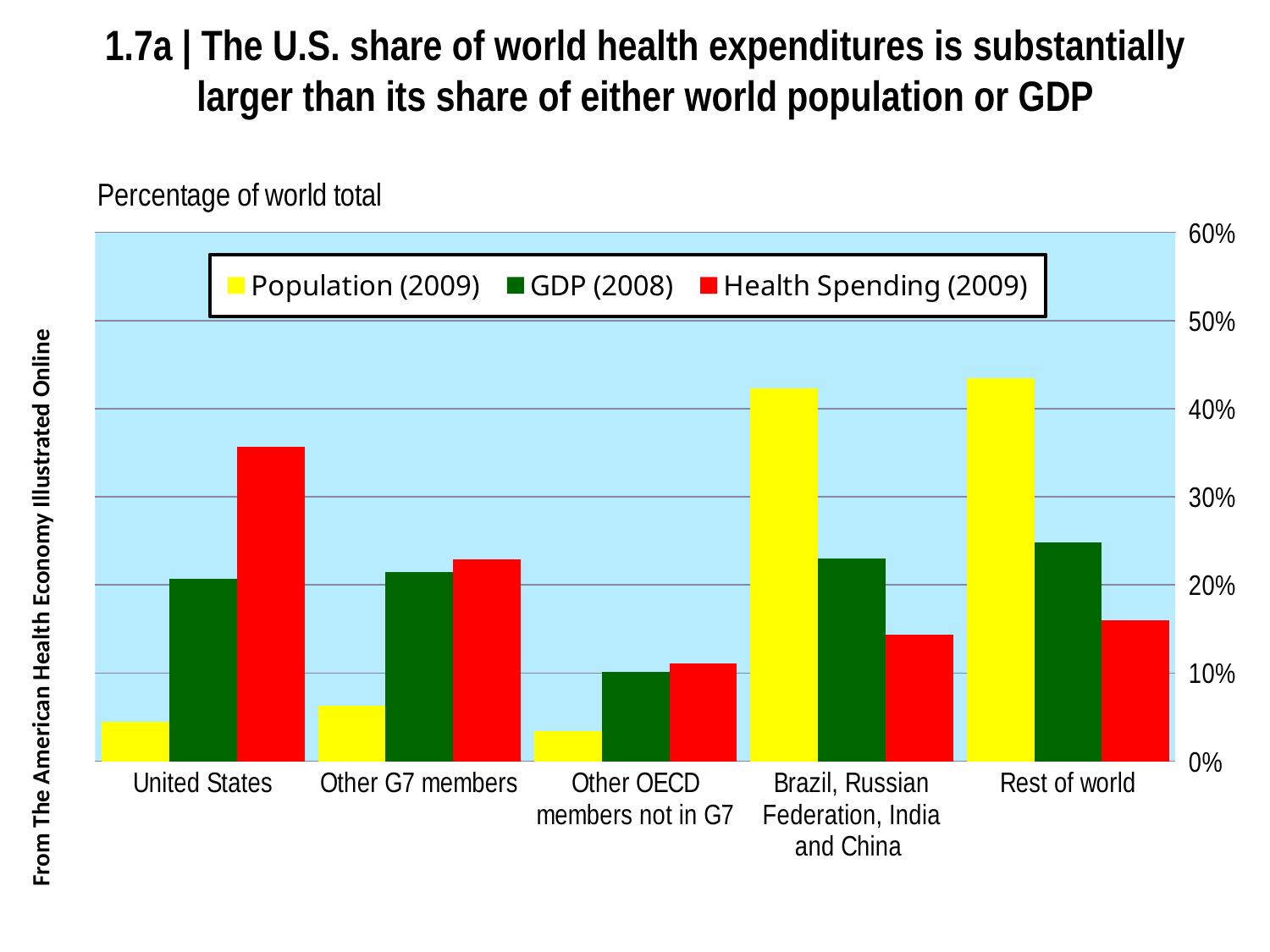
Is the Population (2009) value for Brazil, Russian Federation, India and China greater or less than 40%? greater What does the label above the chart say the values are measured as? Percentage of world total How many categories are shown on the x axis? 5 For Brazil, Russian Federation, India and China, which is larger: Population (2009) or Health Spending (2009)? Population (2009) What kind of chart is shown on the slide? bar chart Is the GDP (2008) value for Other OECD members not in G7 greater or less than 20%? less Is the Health Spending (2009) value for Rest of world greater or less than 20%? less Which colour represents GDP (2008) in the legend? green Which category has the highest Health Spending (2009) value? United States How many series does the legend list? 3 For United States, which is larger: Health Spending (2009) or GDP (2008)? Health Spending (2009)